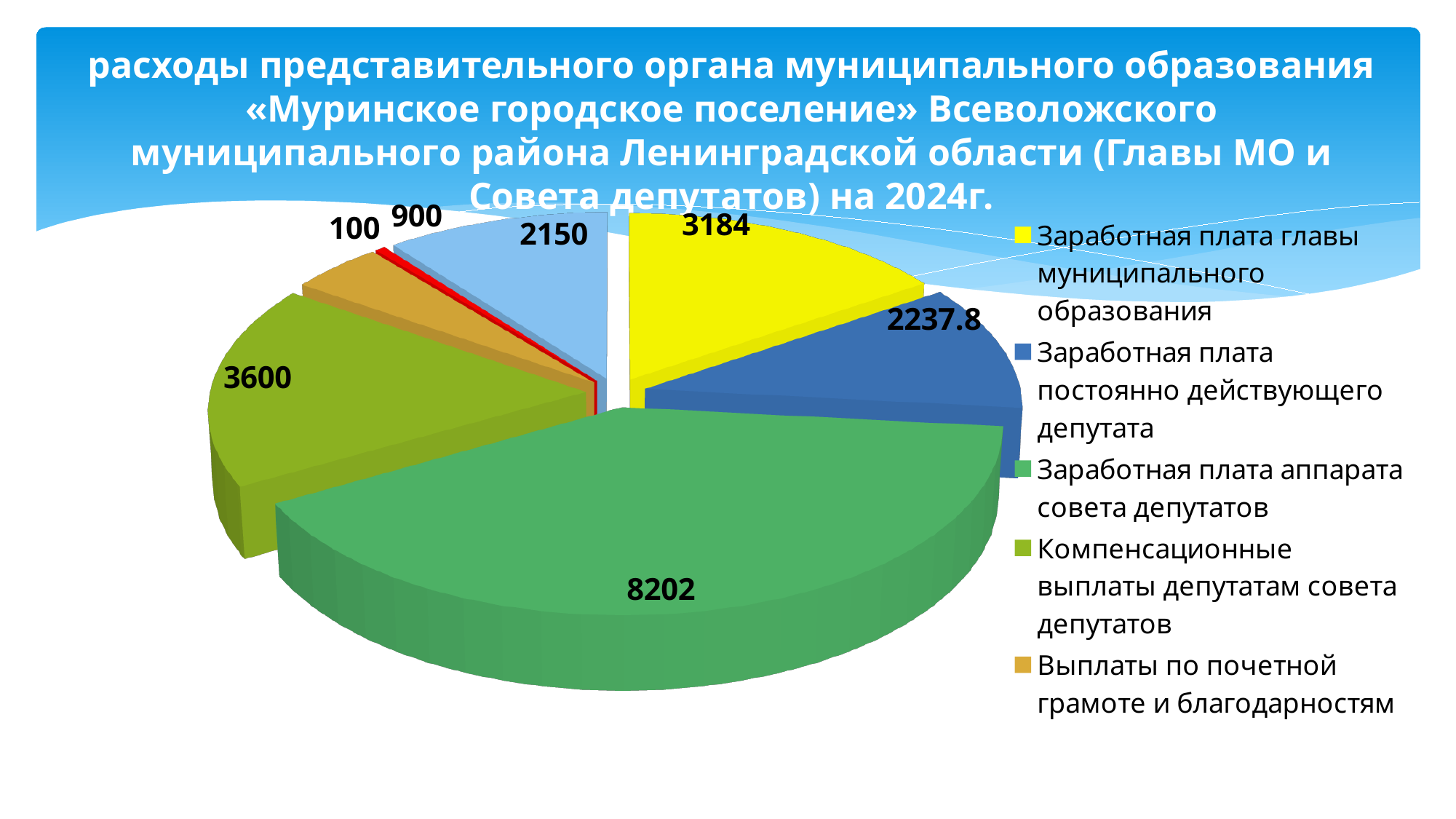
What is the value for Компенсационные выплаты депутатам совета депутатов? 3600 Which category has the largest slice of the pie? Заработная плата аппарата совета депутатов What is the difference between Заработная плата главы муниципального образования and Заработная плата постоянно действующего депутата? 946.2 What type of chart is shown on the slide? Pie chart What is the value for Заработная плата постоянно действующего депутата? 2237.8 What is the difference between Заработная плата аппарата совета депутатов and Компенсационные выплаты депутатам совета депутатов? 4602 What is the smallest value labelled on the pie chart? 100 What is the value for Выплаты по почетной грамоте и благодарностям? 900 What is the value for Заработная плата главы муниципального образования? 3184 How many slices does the pie chart have? 7 What is the value for Заработная плата аппарата совета депутатов? 8202 Which is larger: Компенсационные выплаты депутатам совета депутатов or Заработная плата главы муниципального образования? Компенсационные выплаты депутатам совета депутатов